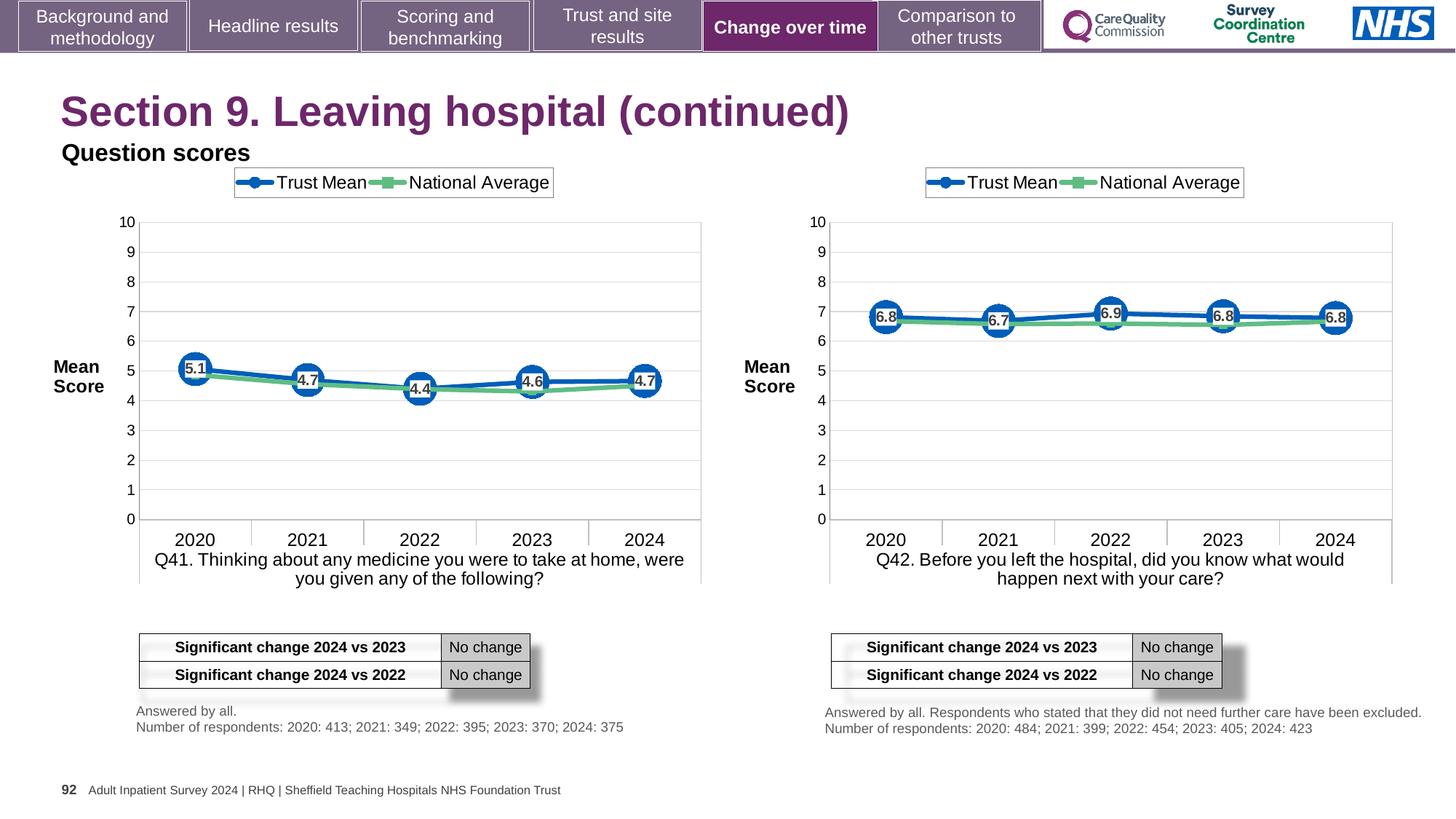
In the Q41 chart on the left, what is the Trust Mean score for 2020? 5.1 In the Q41 chart on the left, what is the difference between the Trust Mean scores for 2020 and 2022? 0.7 In the Q42 chart on the right, what is the difference between the Trust Mean scores for 2022 and 2021? 0.2 In the Q42 chart on the right, which year has the lowest Trust Mean score? 2021 In the Q41 chart on the left, is the Trust Mean score higher in 2021 or in 2022? 2021 How many years are plotted on the x axis of the Q42 chart on the right? 5 How many series does the legend of the Q41 chart on the left list? 2 In the Q42 chart on the right, is the National Average value for 2022 greater or less than 7? less In the Q41 chart on the left, does the Trust Mean rise or fall from 2020 to 2022? fall In the Q42 chart on the right, what is the Trust Mean score for 2022? 6.9 In the Q41 chart on the left, which year has the highest Trust Mean score? 2020 In the Q41 chart on the left, which year has the lowest Trust Mean score? 2022